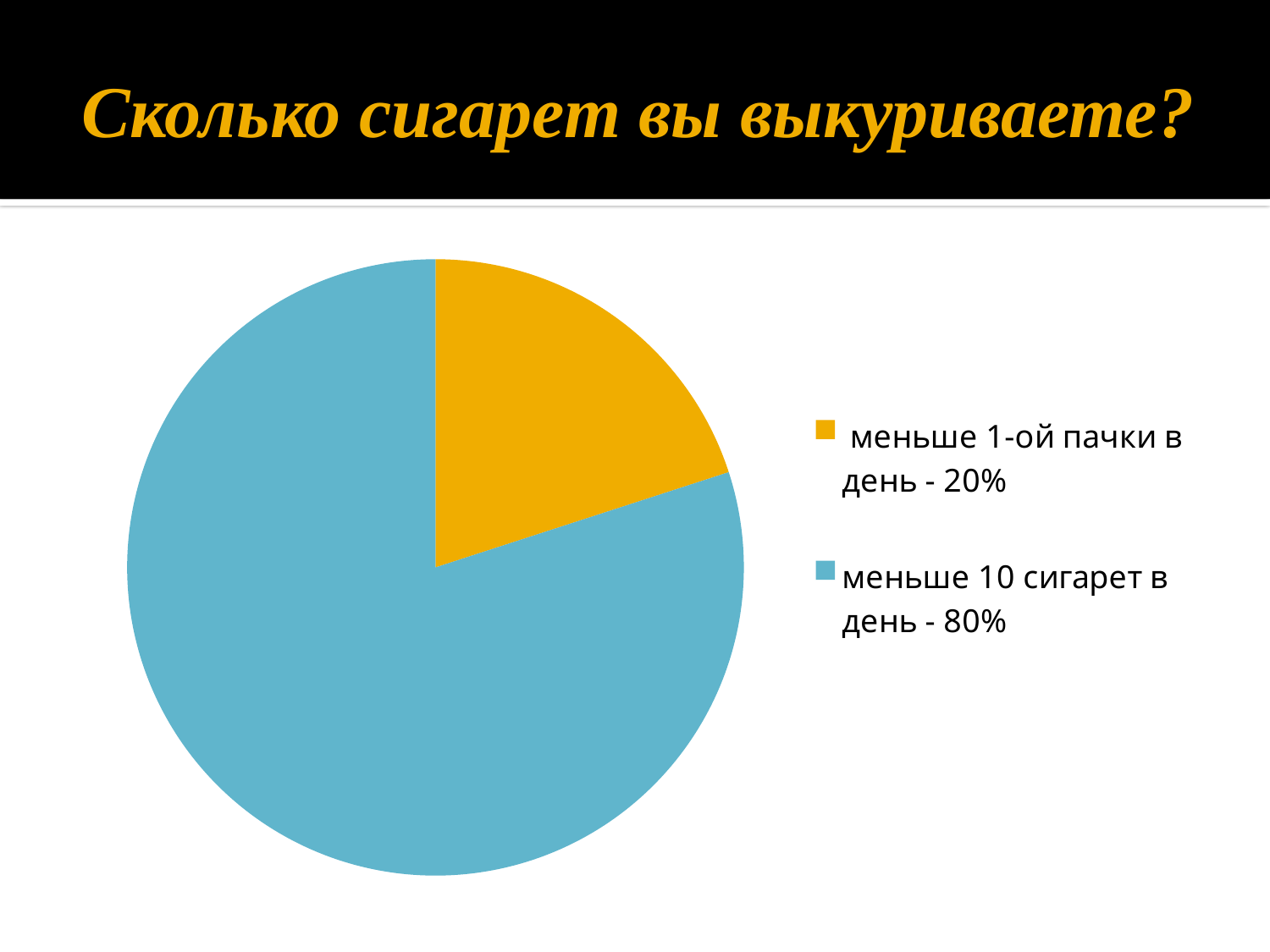
How many slices does the pie chart have? 2 What colour is the slice for 'меньше 10 сигарет в день'? blue How many entries does the legend list? 2 What share of the pie is 'меньше 1-ой пачки в день'? 20% What share of the pie is 'меньше 10 сигарет в день'? 80% Which category has the largest slice of the pie? меньше 10 сигарет в день Which is larger: the share for 'меньше 1-ой пачки в день' or for 'меньше 10 сигарет в день'? меньше 10 сигарет в день What is the title of the slide? Сколько сигарет вы выкуриваете? What kind of chart is shown on the slide? pie chart Which category has the smallest slice of the pie? меньше 1-ой пачки в день What is the difference in percentage points between 'меньше 10 сигарет в день' and 'меньше 1-ой пачки в день'? 60%